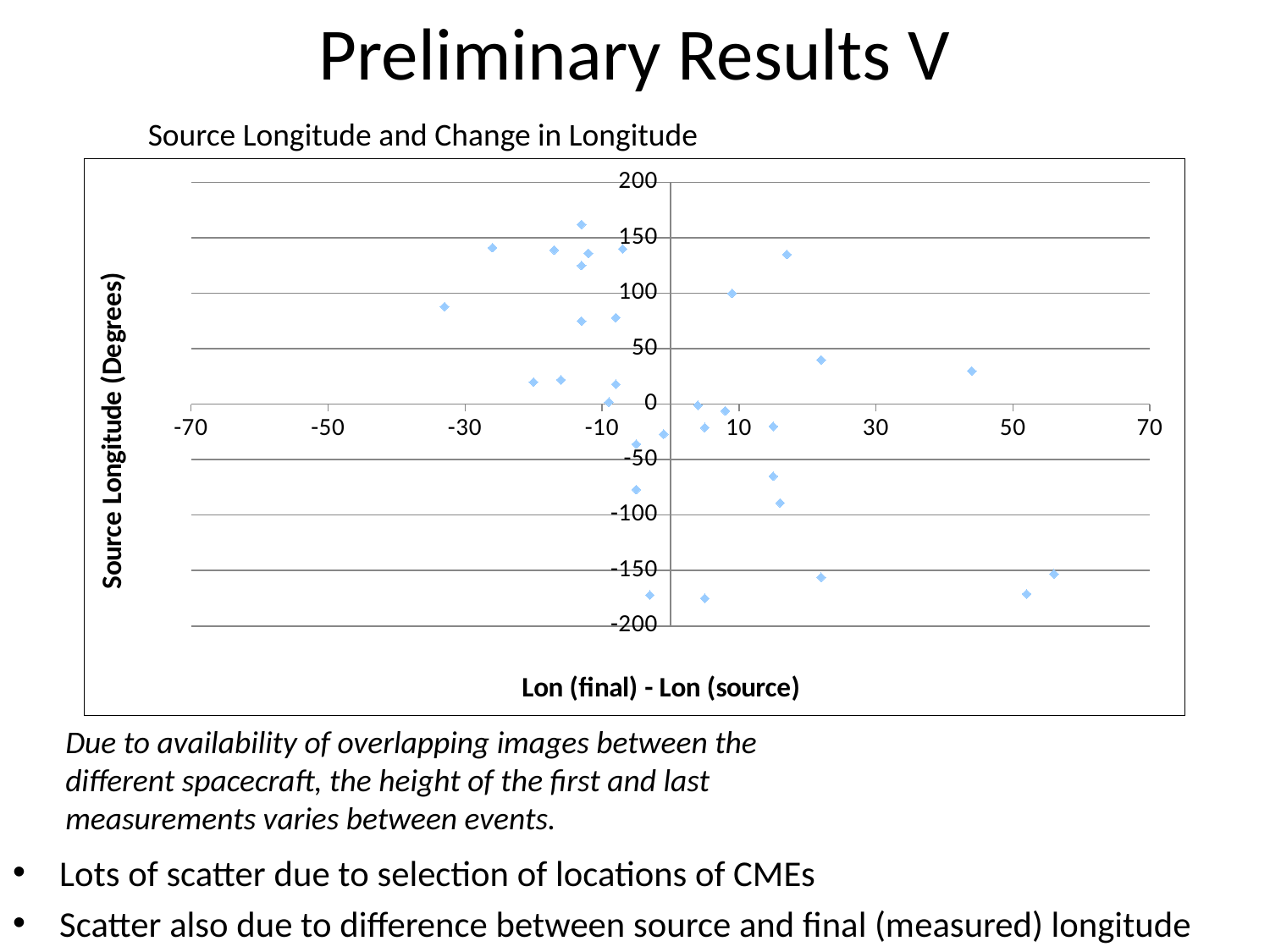
Is the x value of the leftmost point on the chart greater or less than -30? less Is the y value of the point near x = 9 that lies above the x axis greater or less than 50? greater Is the y value of the point near x = 44 greater or less than 50? less What is the title of the chart? Source Longitude and Change in Longitude What is the label of the vertical axis of the chart? Source Longitude (Degrees) What kind of chart is shown on the slide? scatter chart